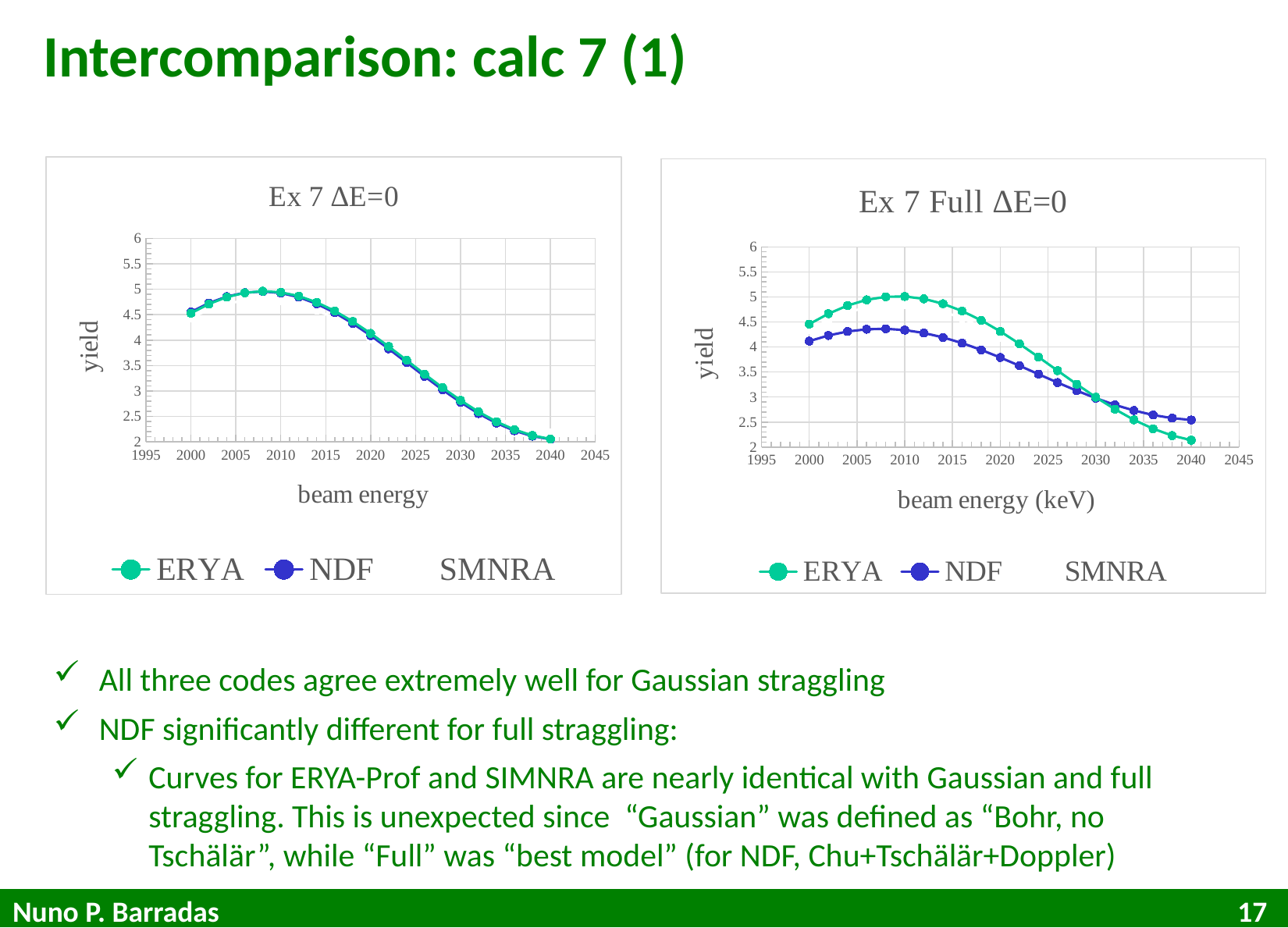
In the right chart "Ex 7 Full ΔE=0", which series has the higher yield at beam energy 2040, ERYA or NDF? NDF In the right chart "Ex 7 Full ΔE=0", which series has the higher yield at beam energy 2010, ERYA or NDF? ERYA In the right chart "Ex 7 Full ΔE=0", is the ERYA yield at beam energy 2005 greater or less than 4.5? greater In the left chart "Ex 7 ΔE=0", is the ERYA yield at beam energy 2010 greater or less than 4? greater What is the title of the left chart? Ex 7 ΔE=0 In the left chart "Ex 7 ΔE=0", do the yield values rise or fall as beam energy increases from 2010 to 2040? fall In the right chart "Ex 7 Full ΔE=0", is the ERYA yield at beam energy 2040 greater or less than 2.5? less What kind of chart is the left chart titled "Ex 7 ΔE=0"? line chart How many series does the legend of the right chart "Ex 7 Full ΔE=0" list? 3 What is the x-axis label of the right chart "Ex 7 Full ΔE=0"? beam energy (keV)